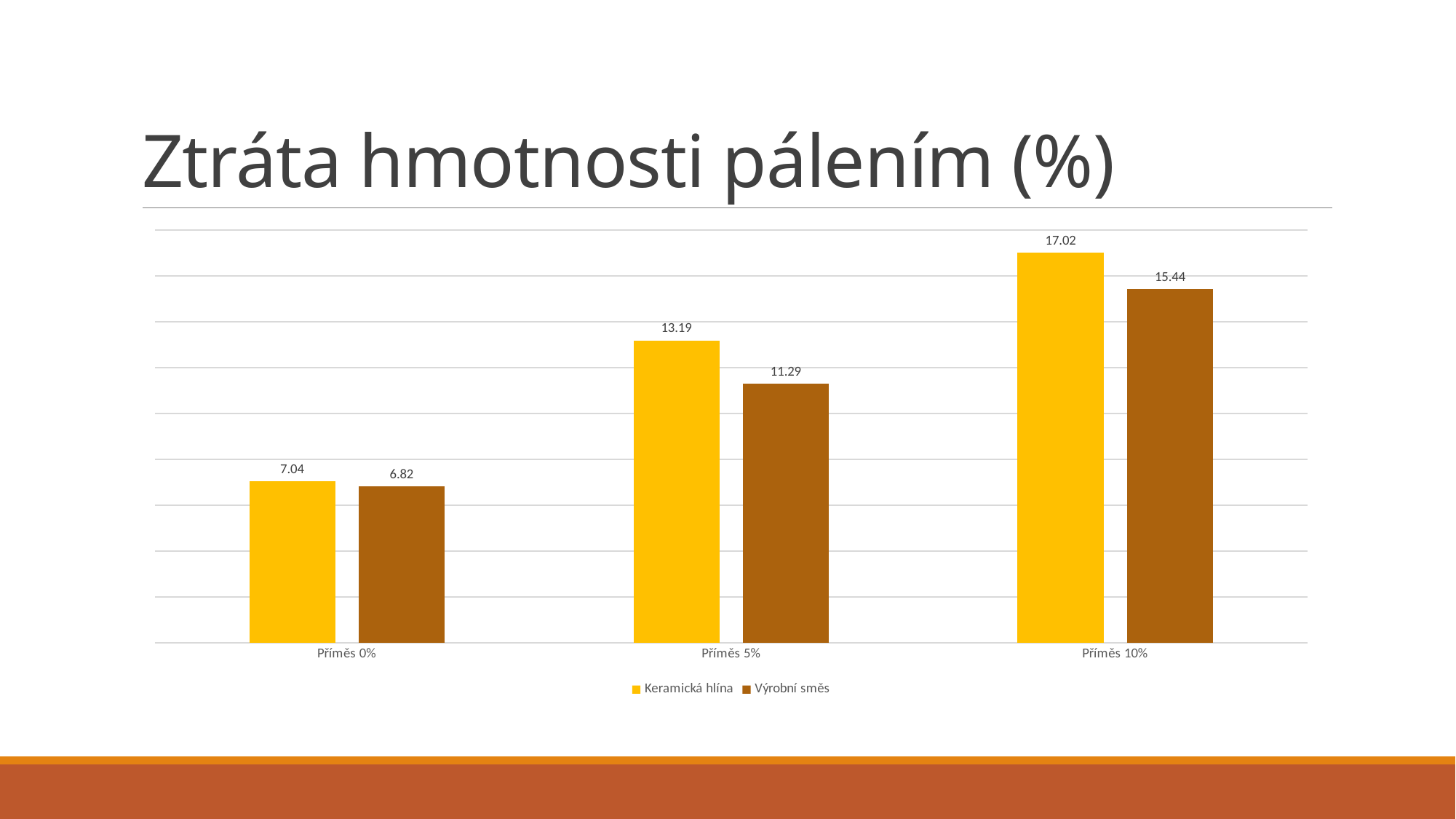
What is the difference between Keramická hlína at Příměs 5% and at Příměs 0%? 6.15 Which is larger at Příměs 5%: Keramická hlína or Výrobní směs? Keramická hlína What is the value for Výrobní směs at Příměs 10%? 15.44 Which category has the lowest value for Výrobní směs? Příměs 0% Do the values for Výrobní směs rise or fall from Příměs 0% to Příměs 10%? rise What is the value for Výrobní směs at Příměs 0%? 6.82 How many categories are shown on the x axis? 3 How many series does the legend list? 2 What kind of chart is shown on the slide? bar chart What is the difference between Keramická hlína and Výrobní směs at Příměs 10%? 1.58 Which category has the highest value for Keramická hlína? Příměs 10% What is the value for Keramická hlína at Příměs 5%? 13.19